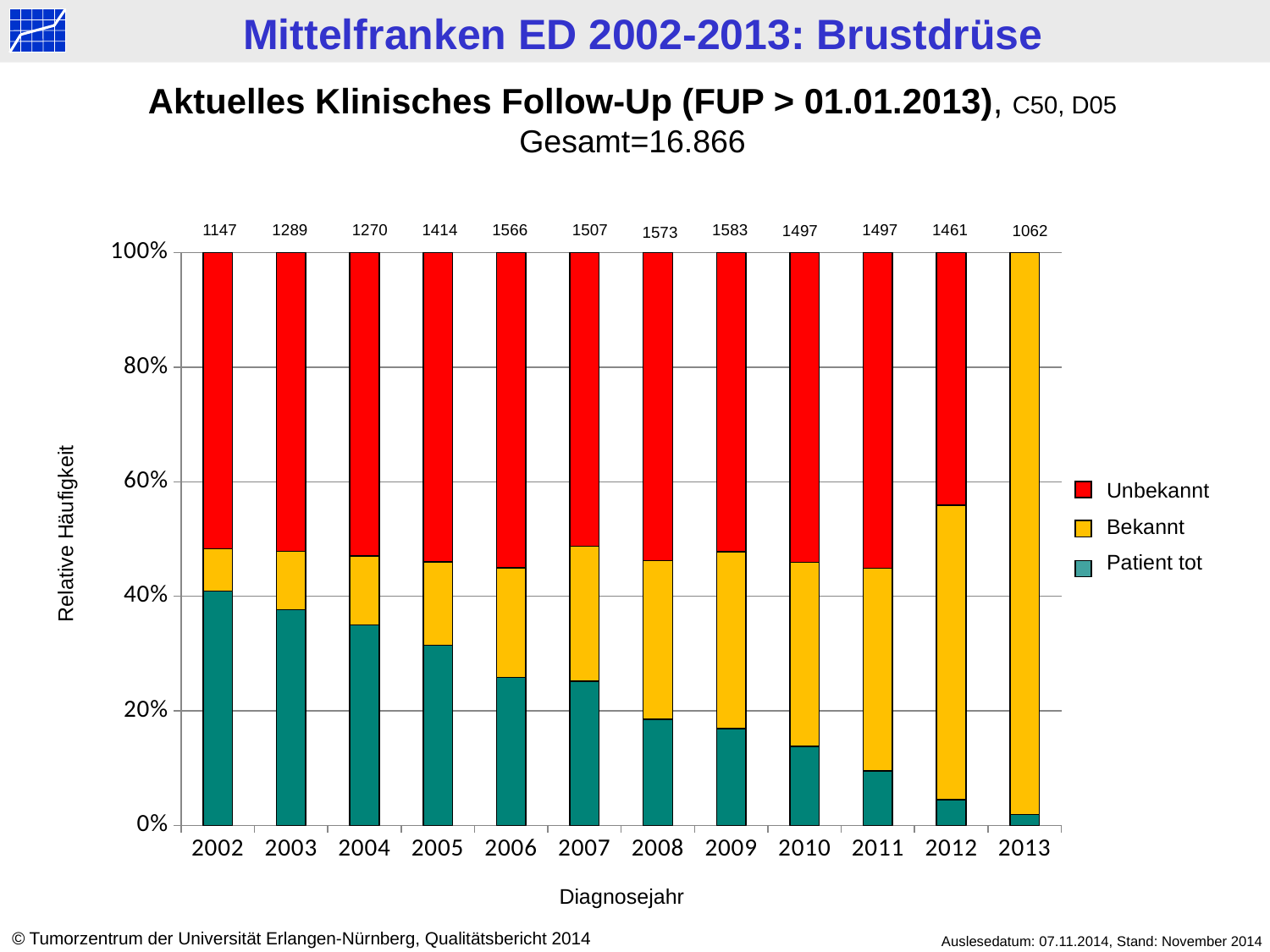
How many series does the legend list? 3 What number is printed above the bar for 2009? 1583 What kind of chart is shown on the slide? stacked bar chart How many diagnosis years (categories) are shown on the x axis? 12 Which year has the lowest number printed above its bar? 2013 Is the 'Patient tot' share for 2004 greater or less than 40%? less Which year has the highest number printed above its bar? 2009 What is the difference between the numbers printed above the bars for 2006 and 2002? 419 Does the 'Patient tot' share rise or fall from 2002 to 2013? fall What is the label of the x axis? Diagnosejahr Which year has the larger number printed above its bar, 2003 or 2004? 2003 What number is printed above the bar for 2013? 1062